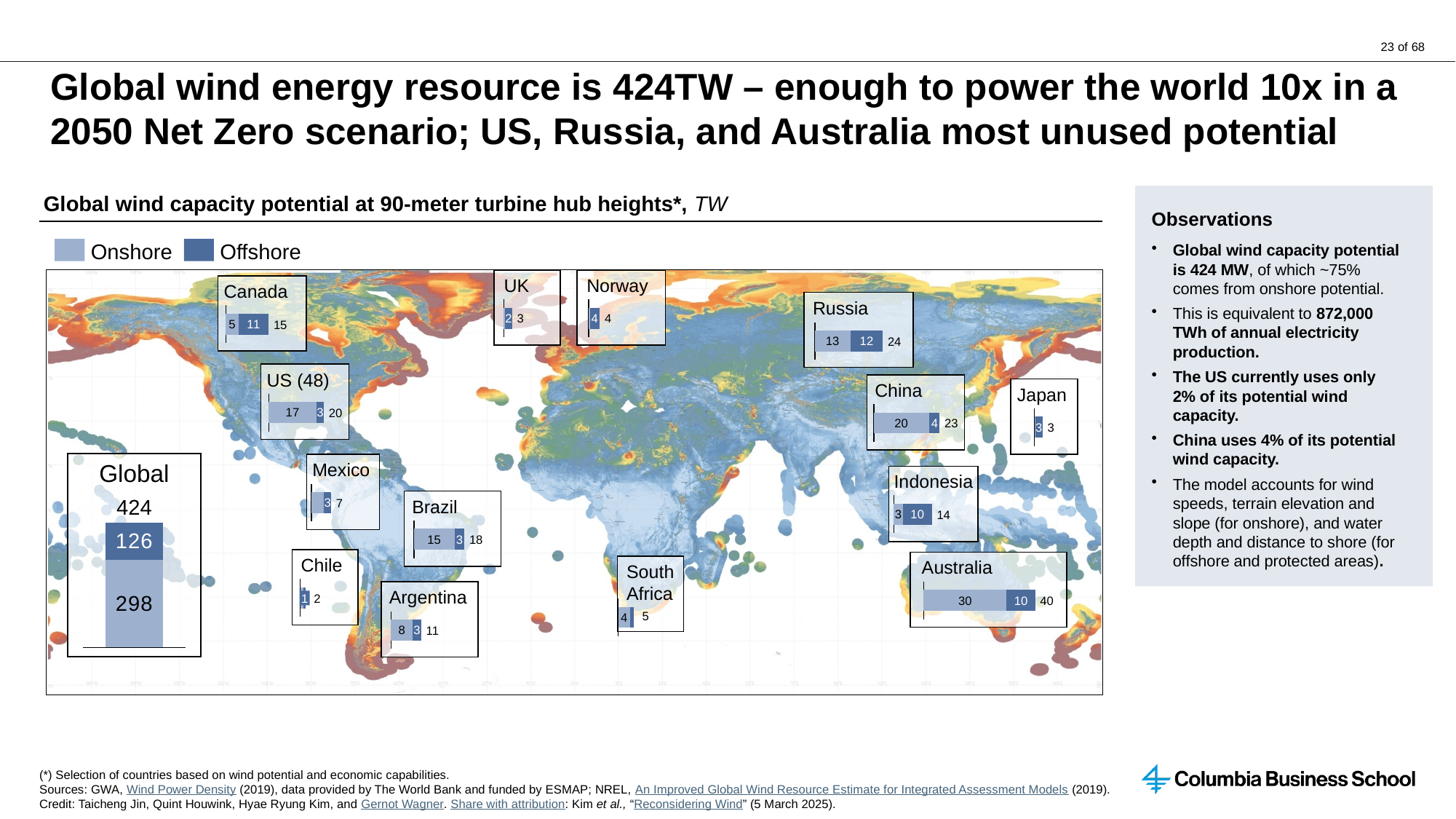
How many series does the legend list? 2 Which has a larger total wind capacity potential, US (48) or China? China What kind of chart is used to show the Global wind capacity potential? Stacked bar chart What is the onshore wind capacity potential shown for Australia? 30 What is the total wind capacity potential shown for Australia? 40 Which country on the map has the highest total wind capacity potential? Australia What is the total global wind capacity potential shown in the Global bar? 424 What is the difference between Australia's onshore and offshore wind capacity potential? 20 What is the onshore value shown in the Global bar? 298 Which country on the map has the lowest total wind capacity potential? Chile What is the offshore value shown in the Global bar? 126 What is the total wind capacity potential shown for Russia? 24